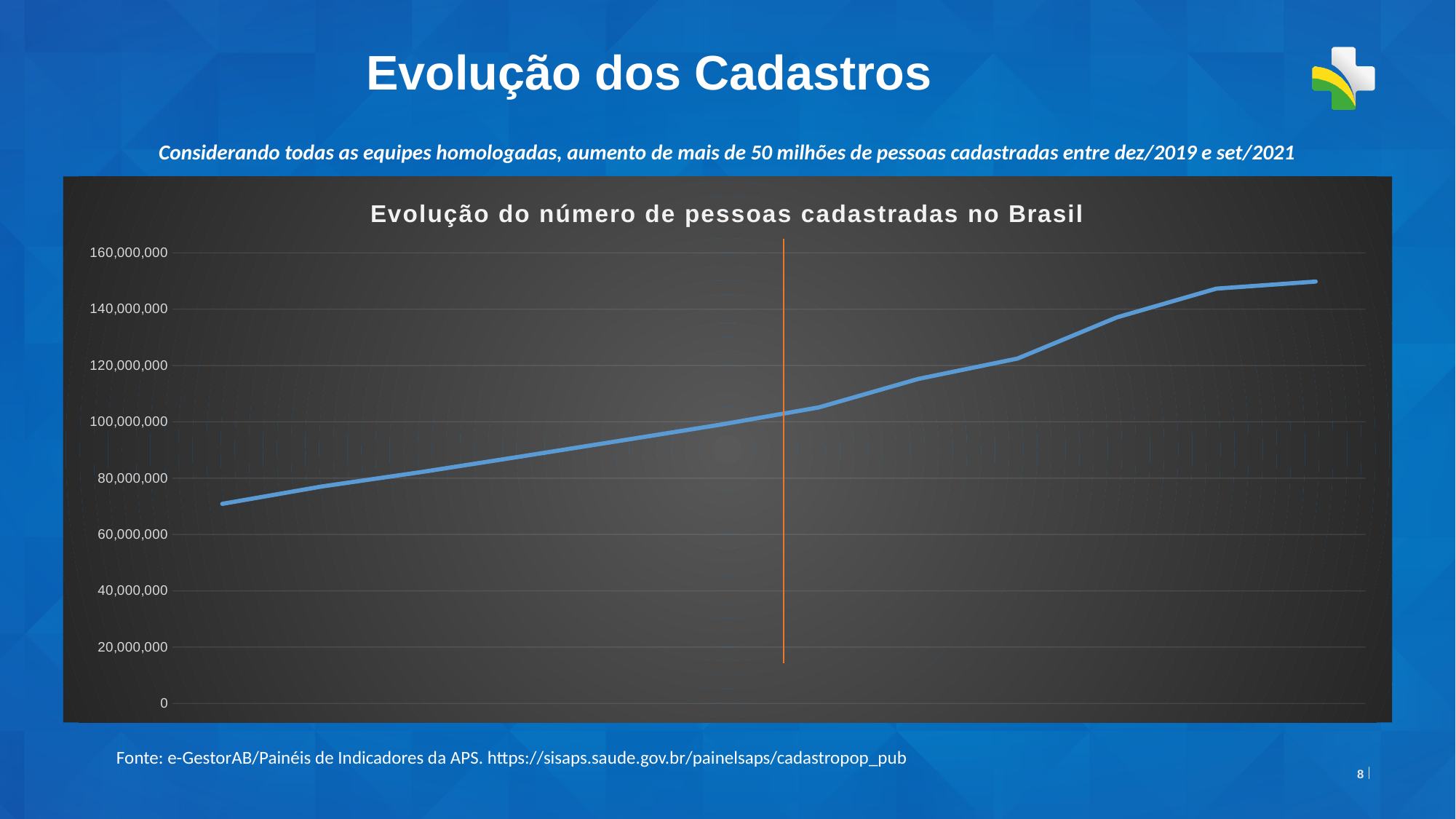
Is the value at the rightmost point of the line greater or less than 140,000,000? greater Is the value at the leftmost point of the line greater or less than 60,000,000? greater Is the value at the leftmost point of the line greater or less than 80,000,000? less Do the values rise or fall from left to right along the x axis? rise What is the title of the chart? Evolução do número de pessoas cadastradas no Brasil What kind of chart is shown on the slide? line chart Which end of the line, leftmost or rightmost, has the higher value? rightmost What is the highest value labelled on the vertical axis? 160,000,000